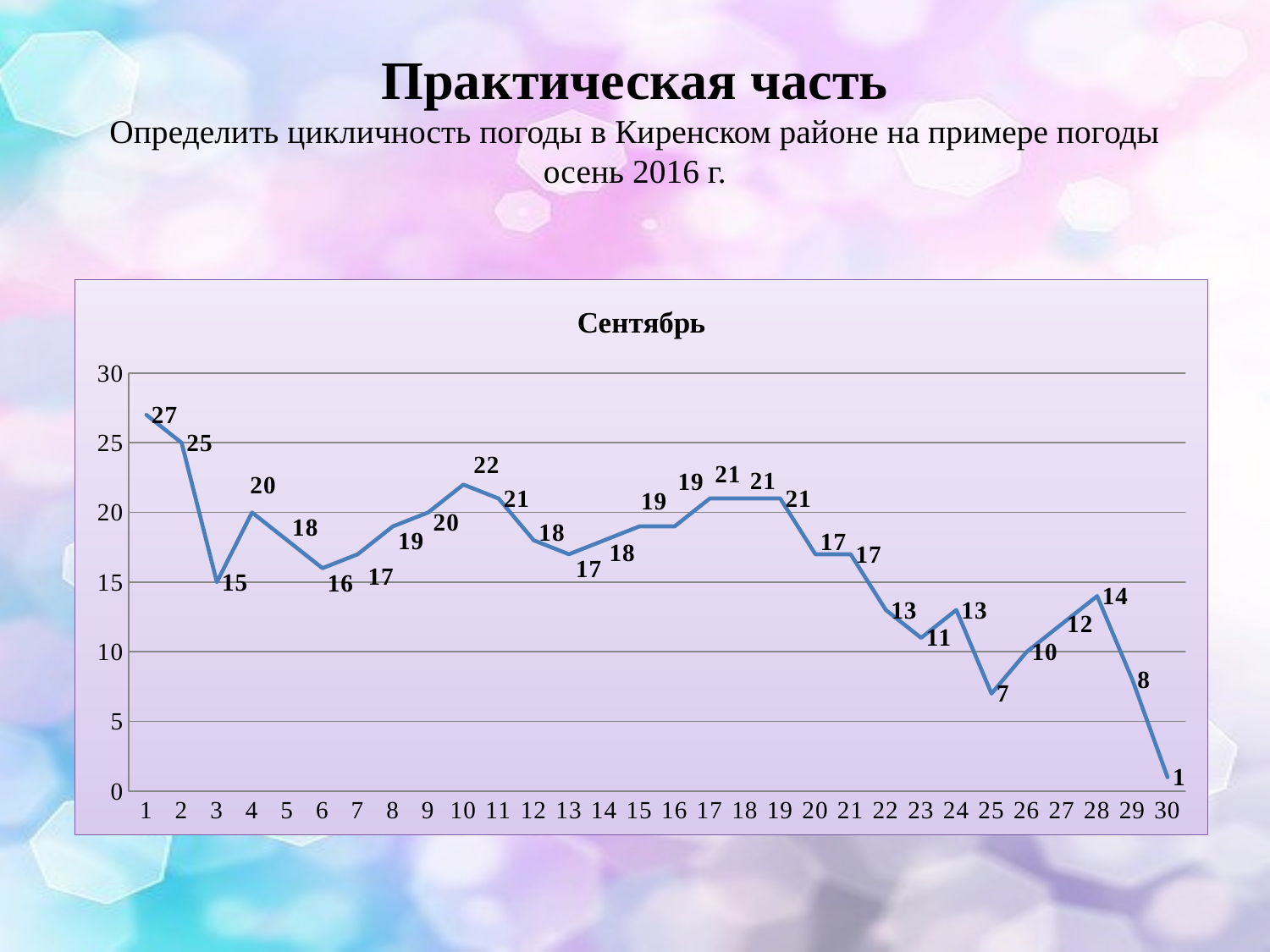
What is the value for day 1? 27 How many days are plotted on the x axis? 30 What is the value for day 30? 1 What is the value for day 10? 22 Which day has the highest value? 1 Which day has the lowest value? 30 What type of chart is shown on the slide? line chart What is the title of the chart? Сентябрь Which is larger, the value for day 4 or the value for day 6? day 4 What is the value for day 25? 7 What is the difference between the values for day 2 and day 3? 10 Overall, do the values rise or fall from day 1 to day 30? fall